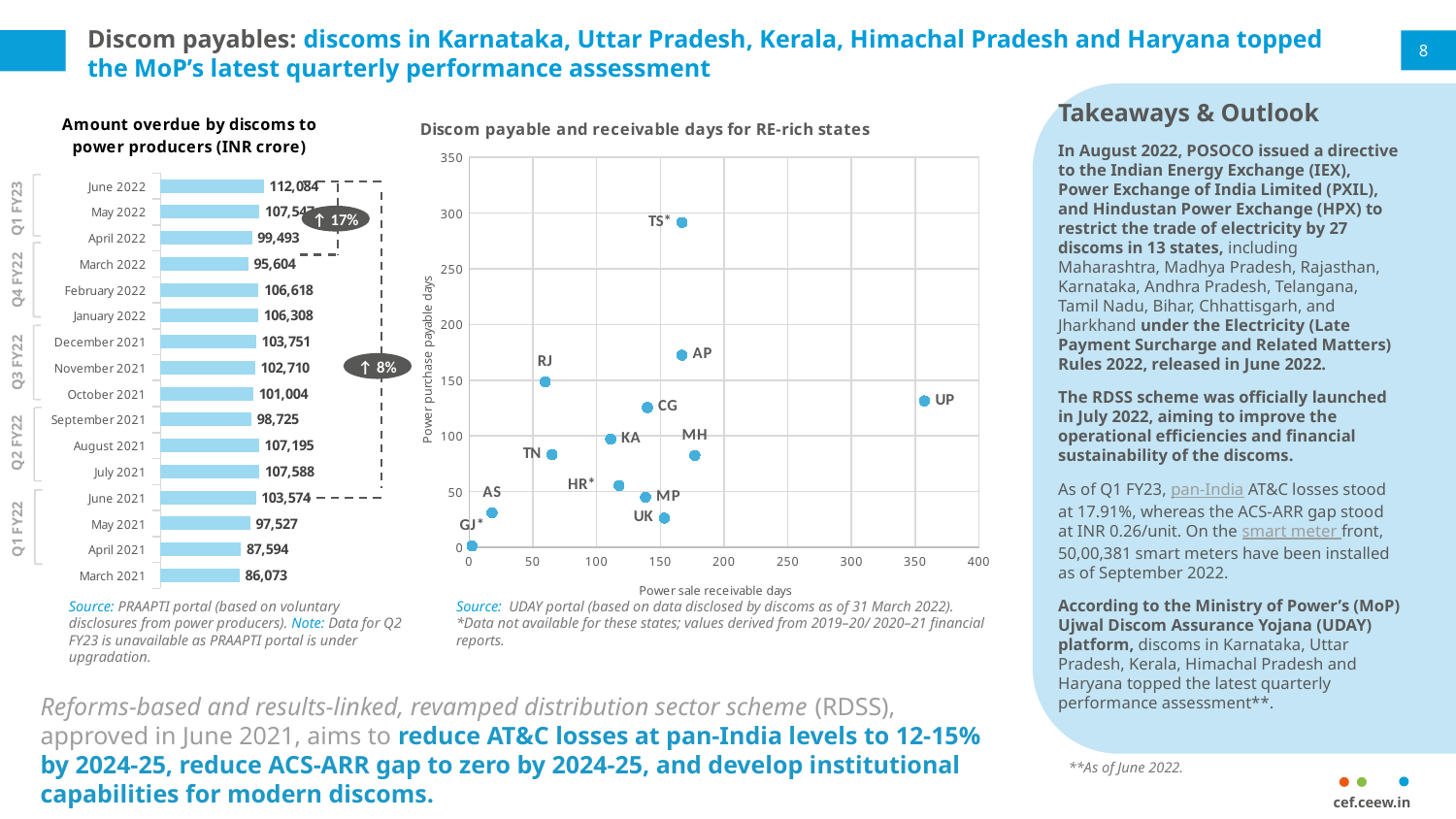
In the 'Amount overdue by discoms to power producers (INR crore)' chart, what is the value for June 2022? 112,084 In the 'Amount overdue by discoms to power producers (INR crore)' chart, what is the difference between the values for June 2022 and March 2021? 26,011 In the 'Amount overdue by discoms to power producers (INR crore)' chart, which month has the lowest value? March 2021 In the 'Discom payable and receivable days for RE-rich states' chart, is the power purchase payable days value for TS* greater or less than 250? greater In the 'Discom payable and receivable days for RE-rich states' chart, is the power sale receivable days value for UP greater or less than 300? greater How many months are shown in the 'Amount overdue by discoms to power producers (INR crore)' chart? 16 In the 'Amount overdue by discoms to power producers (INR crore)' chart, which month has the highest value? June 2022 In the 'Amount overdue by discoms to power producers (INR crore)' chart, what is the value for March 2021? 86,073 In the 'Amount overdue by discoms to power producers (INR crore)' chart, which is larger, the value for July 2021 or the value for September 2021? July 2021 What kind of chart is 'Discom payable and receivable days for RE-rich states'? Scatter chart What is the label of the horizontal axis in the 'Discom payable and receivable days for RE-rich states' chart? Power sale receivable days In the 'Amount overdue by discoms to power producers (INR crore)' chart, what is the value for December 2021? 103,751